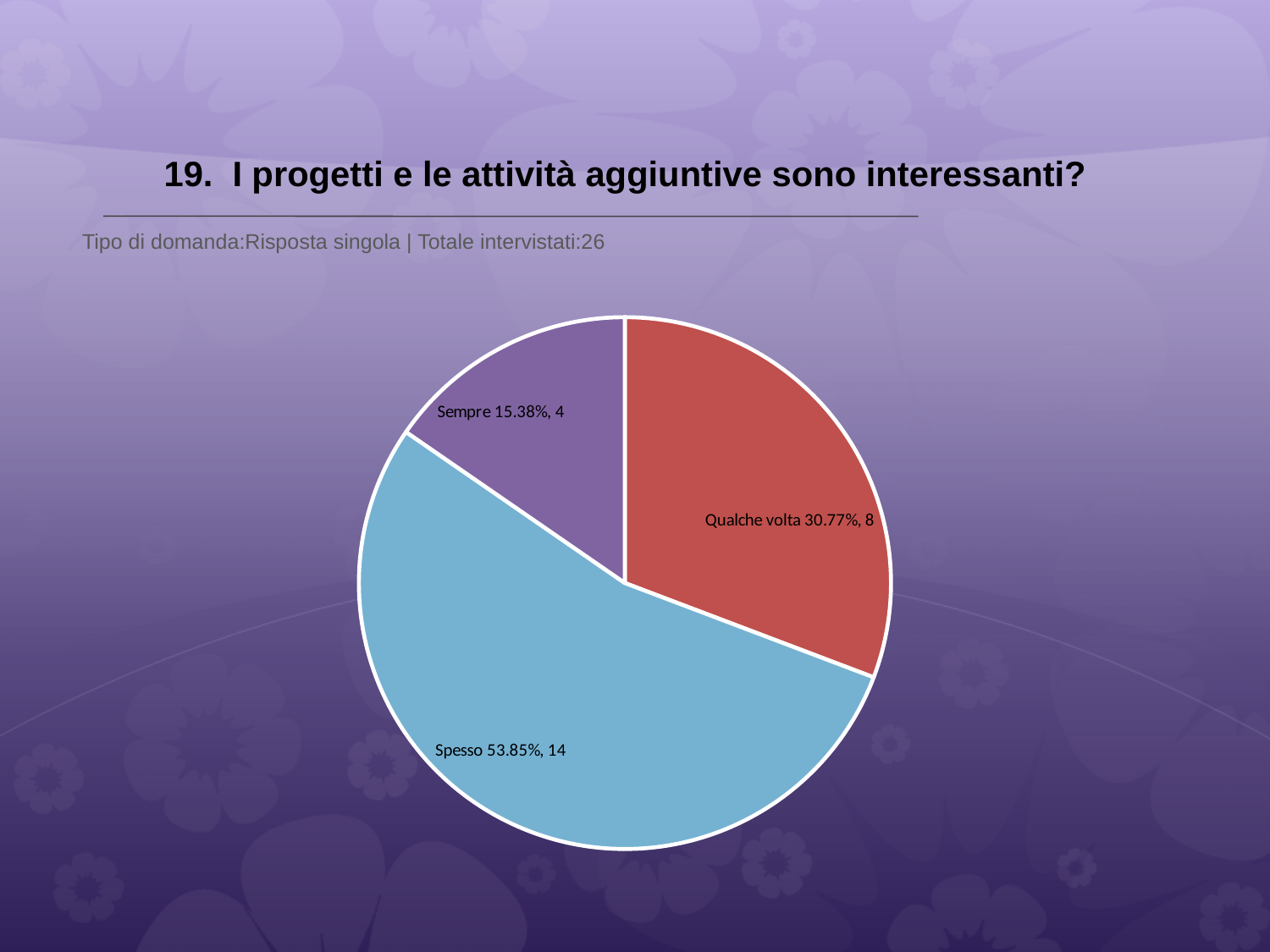
What percentage share does the 'Spesso' slice have? 53.85% How many respondents answered 'Qualche volta'? 8 Which category has the largest slice? Spesso What is the difference in respondent count between 'Spesso' and 'Qualche volta'? 6 Which category has the smallest slice? Sempre What percentage share does the 'Sempre' slice have? 15.38% Which has more respondents, 'Qualche volta' or 'Sempre'? Qualche volta How many slices does the pie chart have? 3 How many respondents answered 'Spesso'? 14 What percentage share does the 'Qualche volta' slice have? 30.77% How many respondents answered 'Sempre'? 4 What kind of chart is shown on the slide? pie chart